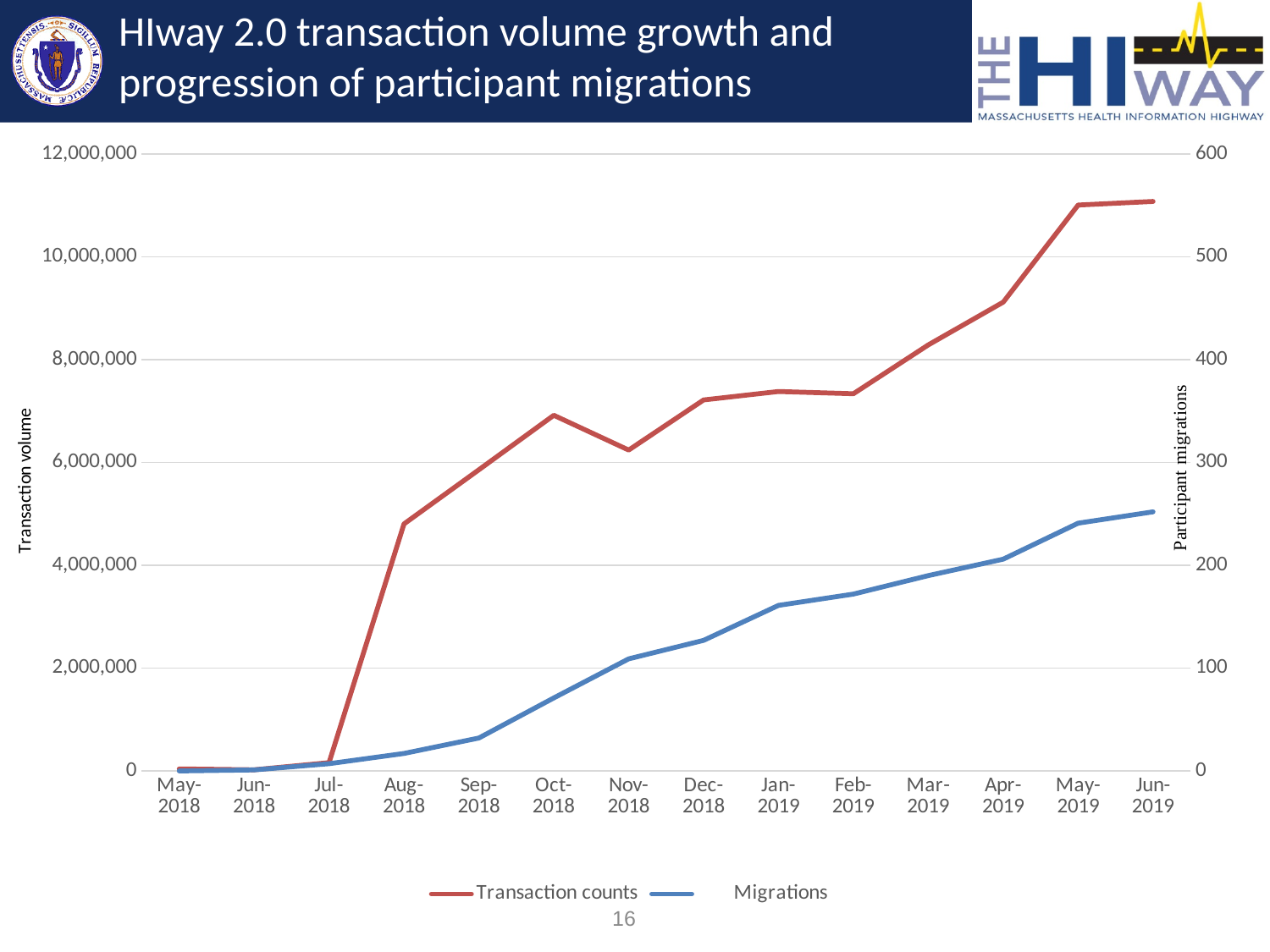
Which is larger for Transaction counts, Oct-2018 or Nov-2018? Oct-2018 Do the Migrations values rise or fall from May-2018 to Jun-2019? Rise Is the value for Transaction counts in Jun-2019 greater or less than 10,000,000? greater Is the value for Transaction counts in Oct-2018 greater or less than 6,000,000? greater Is the value for Migrations in Sep-2018 greater or less than 100? less How many series does the legend list? 2 Which month has the highest value for Migrations? Jun-2019 How many months are plotted along the x axis? 14 What is the title of the right-hand vertical axis? Participant migrations What kind of chart is shown on the slide? Line chart